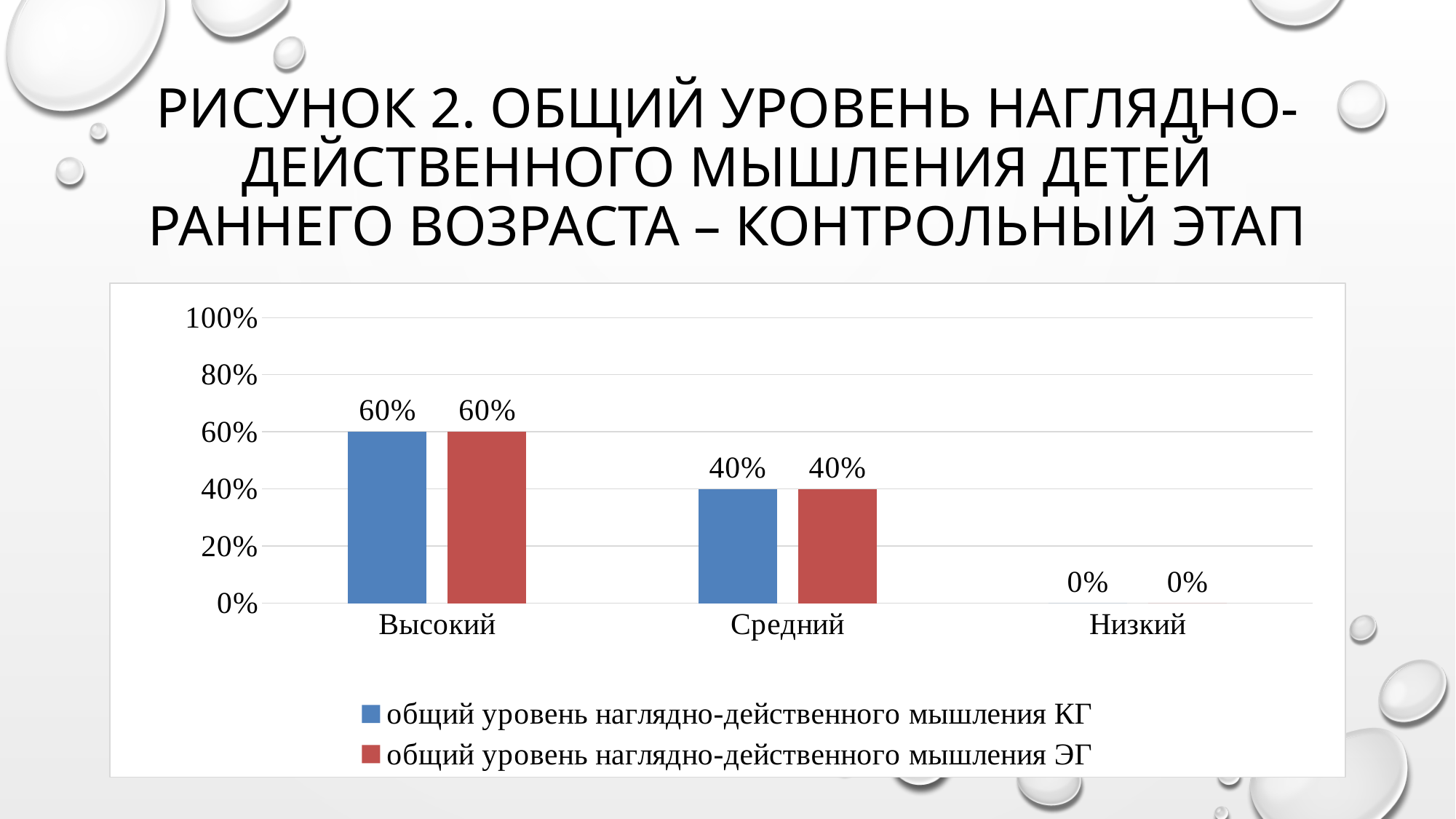
What colour are the bars for the ЭГ series (общий уровень наглядно-действенного мышления ЭГ)? Red Do the values rise or fall from Высокий to Низкий along the x axis? Fall How many categories are shown on the x axis? 3 What is the value for Средний in the ЭГ series (общий уровень наглядно-действенного мышления ЭГ)? 40% Which category has the highest value in the ЭГ series? Высокий What is the value for Высокий in the КГ series (общий уровень наглядно-действенного мышления КГ)? 60% What kind of chart is shown on the slide? Bar chart What is the value for Низкий in the КГ series? 0% Which category has the lowest value in the КГ series? Низкий What is the difference between the КГ values for Высокий and Средний? 20% How many series does the legend list? 2 Which is larger in the ЭГ series: the value for Высокий or the value for Средний? Высокий